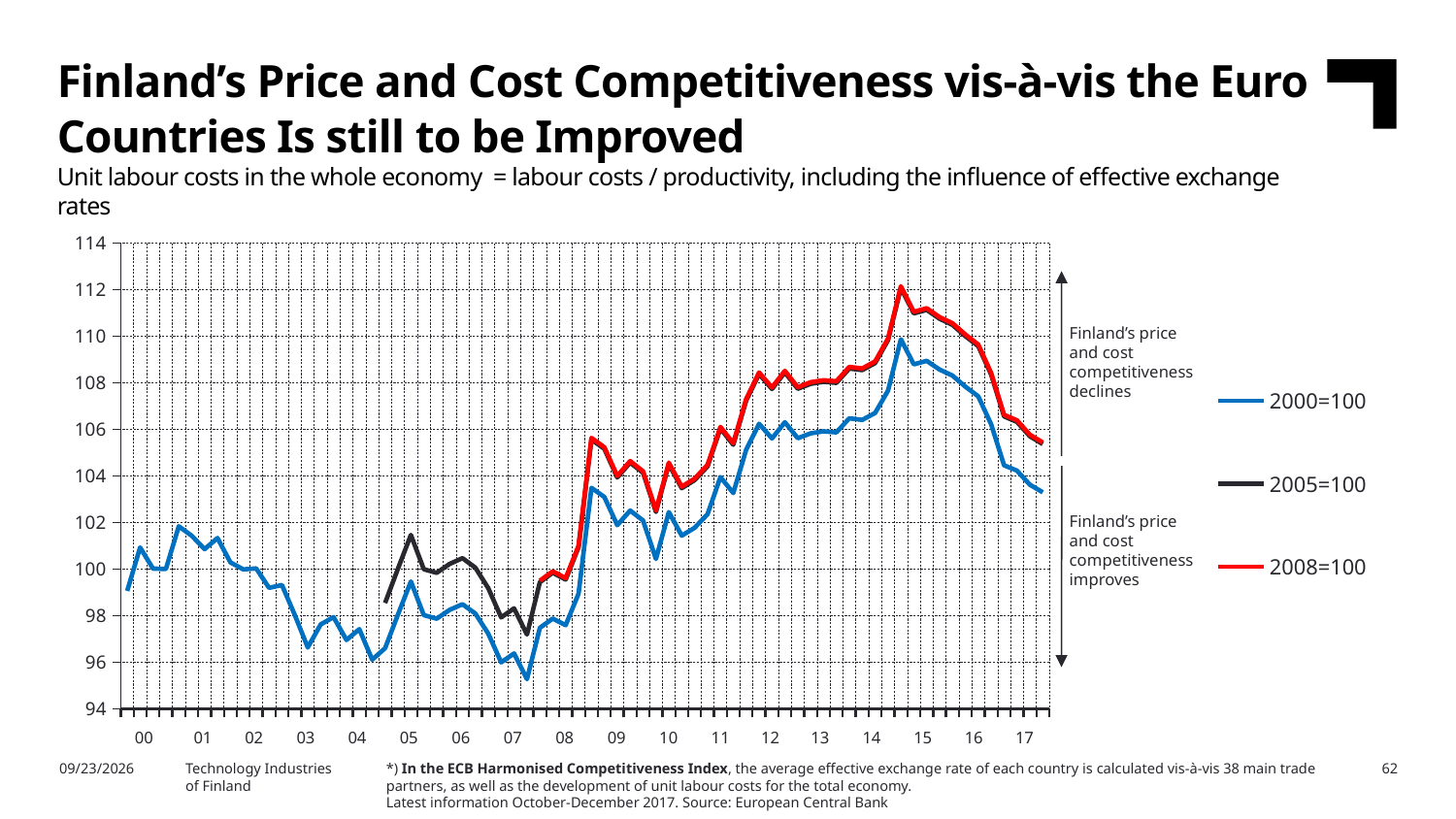
Which series is drawn in blue? 2000=100 Which series reaches the highest value on the chart? 2008=100 How many series does the legend list? 3 Is the value of the 2008=100 series at the end of 2017 greater or less than 104? greater What kind of chart is shown on the slide? line chart In 2015, which series has the higher value, 2008=100 or 2000=100? 2008=100 Is the peak value of the 2008=100 series around 2015 greater or less than 110? greater Do the values of the 2000=100 series rise or fall from 2015 to 2017? fall Is the value of the 2000=100 series at its lowest point around 2007 greater or less than 98? less How many year labels are shown along the x axis? 18 Which series is drawn in red? 2008=100